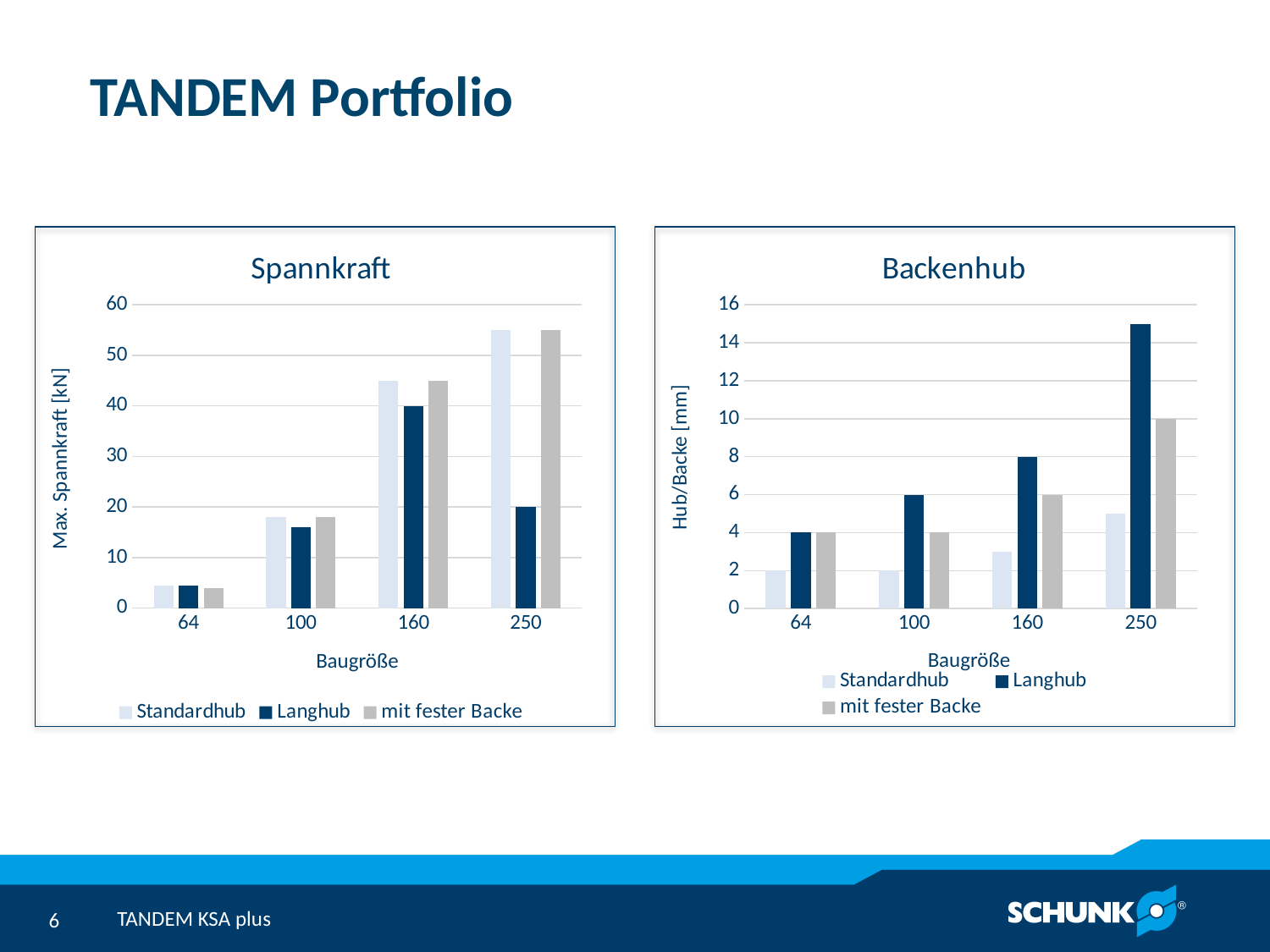
In the Spannkraft chart, which is larger for Baugröße 250: Standardhub or Langhub? Standardhub In the Spannkraft chart, is the Standardhub value for Baugröße 250 greater or less than 50? greater In the Backenhub chart, which Baugröße has the highest Langhub value? 250 How many series does the legend of the Backenhub chart list? 3 How many Baugröße categories are shown on the x axis of the Spannkraft chart? 4 In the Backenhub chart, is the Langhub value for Baugröße 250 greater or less than 14? greater What kind of chart is the Spannkraft chart on the left? bar chart In the Backenhub chart, what is the Langhub value for Baugröße 100? 6 In the Backenhub chart, what is the Langhub value for Baugröße 160? 8 In the Backenhub chart, what is the Standardhub value for Baugröße 64? 2 What is the y-axis label of the Spannkraft chart? Max. Spannkraft [kN] In the Backenhub chart, what is the mit fester Backe value for Baugröße 250? 10